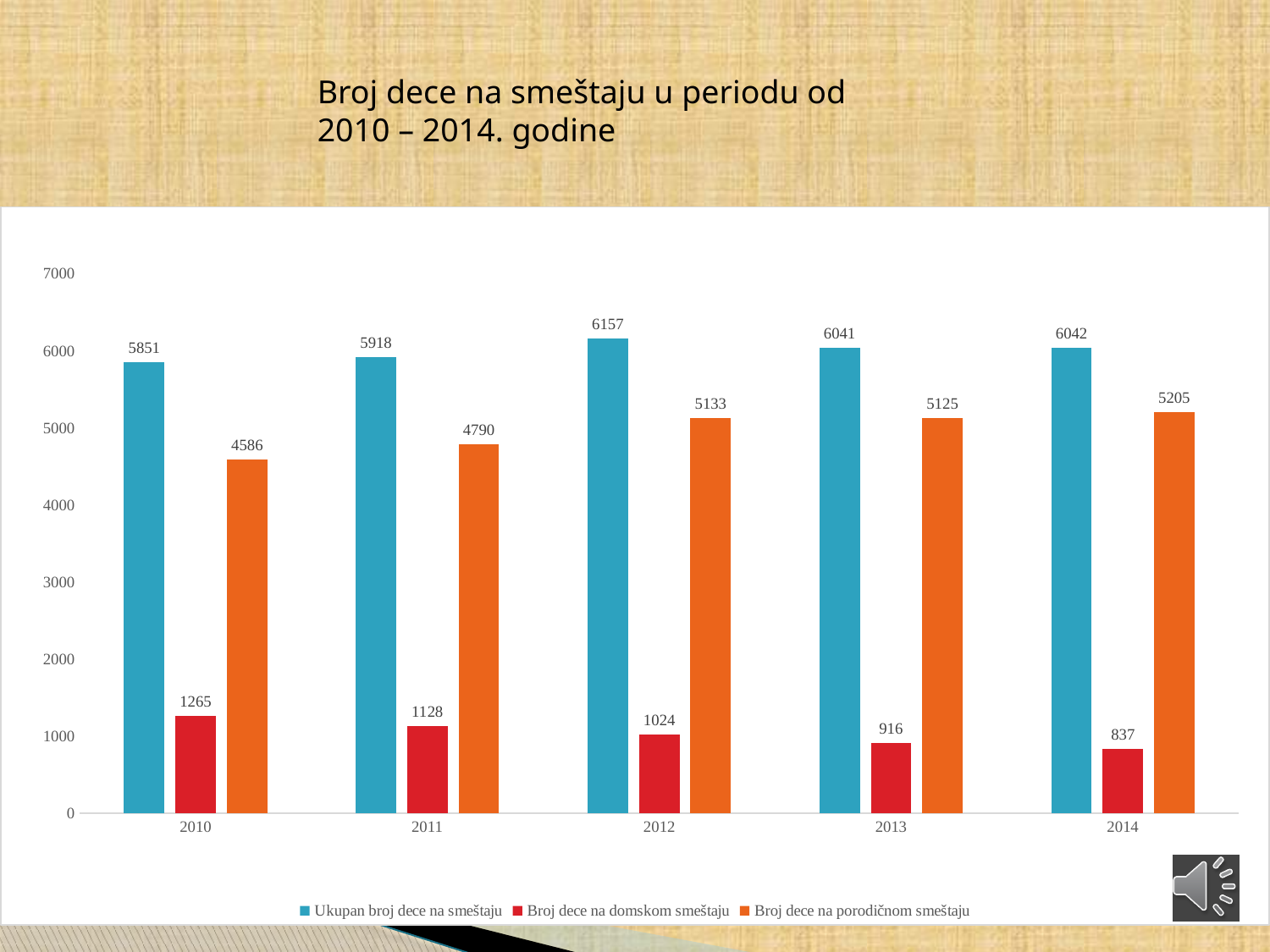
What is the difference between 'Broj dece na porodičnom smeštaju' in 2014 and in 2010? 619 How many years are shown on the x axis? 5 Does 'Broj dece na domskom smeštaju' rise or fall from 2010 to 2014? fall Is the value for 'Broj dece na porodičnom smeštaju' in 2010 greater or less than 5000? less What is the value of 'Ukupan broj dece na smeštaju' for 2012? 6157 What is the value of 'Broj dece na domskom smeštaju' for 2014? 837 What kind of chart is shown on the slide? bar chart What is the value of 'Broj dece na porodičnom smeštaju' for 2011? 4790 How many series does the legend list? 3 Which is larger: 'Broj dece na domskom smeštaju' in 2010 or in 2013? 2010 In which year is 'Broj dece na domskom smeštaju' lowest? 2014 In which year is 'Ukupan broj dece na smeštaju' highest? 2012